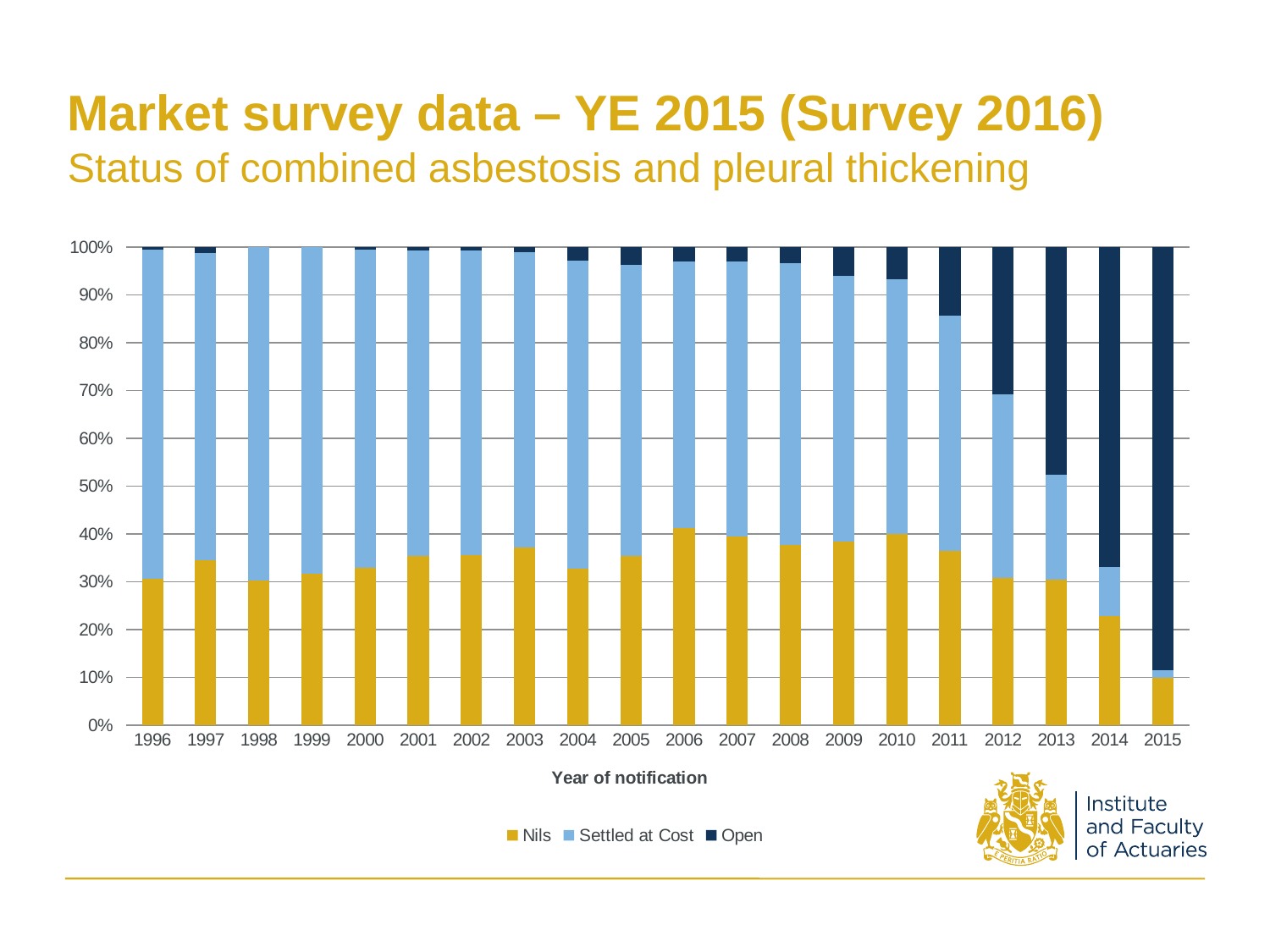
What kind of chart is shown on the slide? Stacked bar chart Is the Open share for 2013 greater or less than 40%? greater Does the Open share rise or fall across the years from 2009 to 2015? Rises Is the Nils share for 2015 greater or less than 20%? less How many years of notification are shown on the x axis? 20 What is the title of the x axis? Year of notification In which year of notification is the Open share the largest? 2015 Which series is shown in dark blue in the legend? Open Is the Open share for 2015 greater or less than 80%? greater How many series does the legend list? 3 Which year has the larger Nils share, 2013 or 2014? 2013 In which year of notification is the Nils share the smallest? 2015